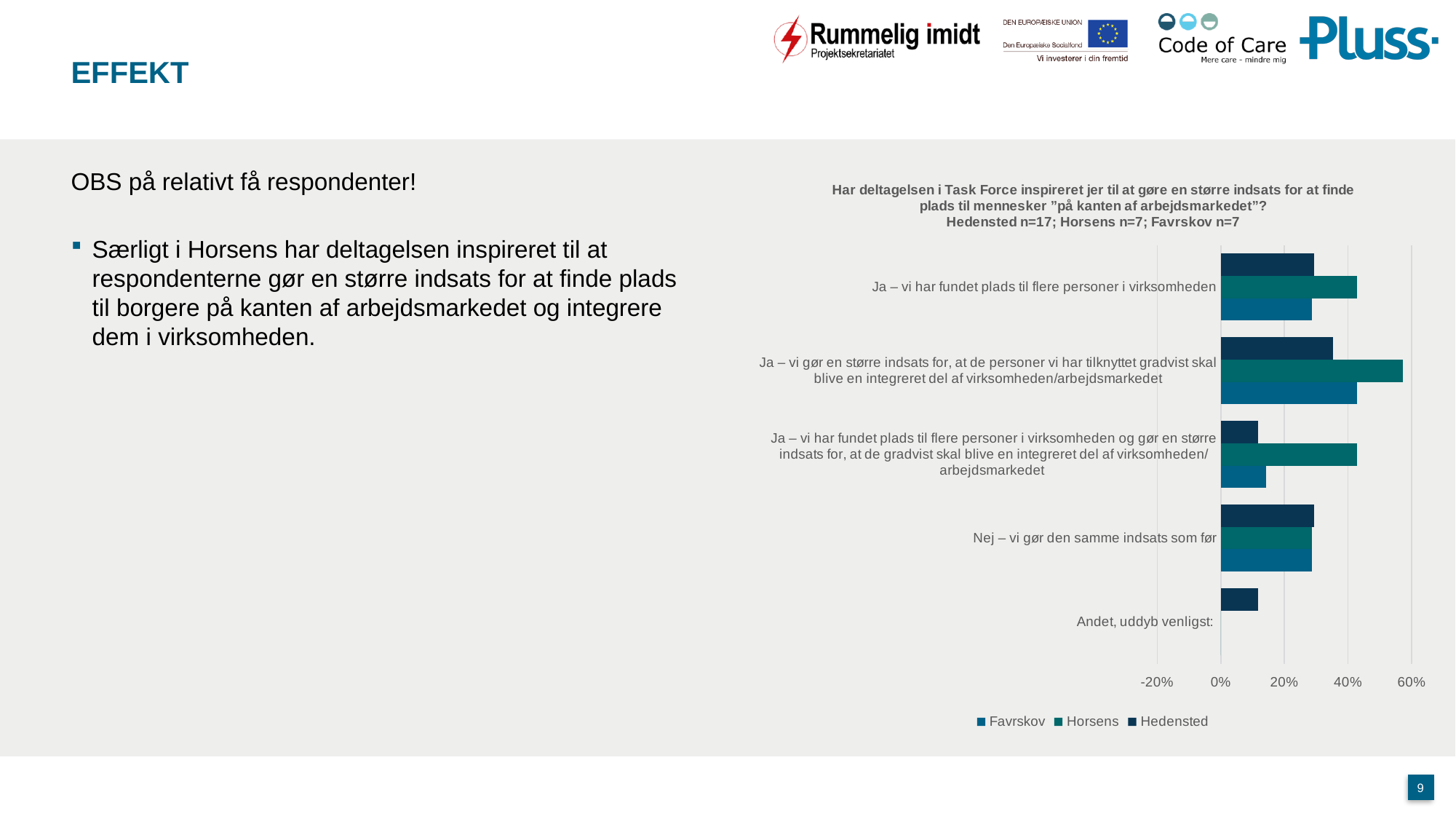
Which series has the highest value in the category "Ja – vi gør en større indsats for, at de personer vi har tilknyttet gradvist skal blive en integreret del af virksomheden/arbejdsmarkedet"? Horsens Which series are listed in the chart legend? Favrskov, Horsens, Hedensted Is the value for Favrskov in the category "Ja – vi gør en større indsats for, at de personer vi har tilknyttet gradvist skal blive en integreret del af virksomheden/arbejdsmarkedet" greater or less than 20%? greater Is the value for Hedensted in the category "Ja – vi har fundet plads til flere personer i virksomheden og gør en større indsats for, at de gradvist skal blive en integreret del af virksomheden/arbejdsmarkedet" greater or less than 20%? less In the category "Ja – vi har fundet plads til flere personer i virksomheden", which is larger: Horsens or Hedensted? Horsens In the category "Ja – vi har fundet plads til flere personer i virksomheden og gør en større indsats for, at de gradvist skal blive en integreret del af virksomheden/arbejdsmarkedet", which is larger: Horsens or Favrskov? Horsens What kind of chart is shown on the slide? Bar chart How many series does the chart legend list? 3 Is the value for Hedensted in the category "Andet, uddyb venligst:" greater or less than 20%? less Which category contains the longest bar in the chart? Ja – vi gør en større indsats for, at de personer vi har tilknyttet gradvist skal blive en integreret del af virksomheden/arbejdsmarkedet How many response categories are shown on the chart's vertical axis? 5